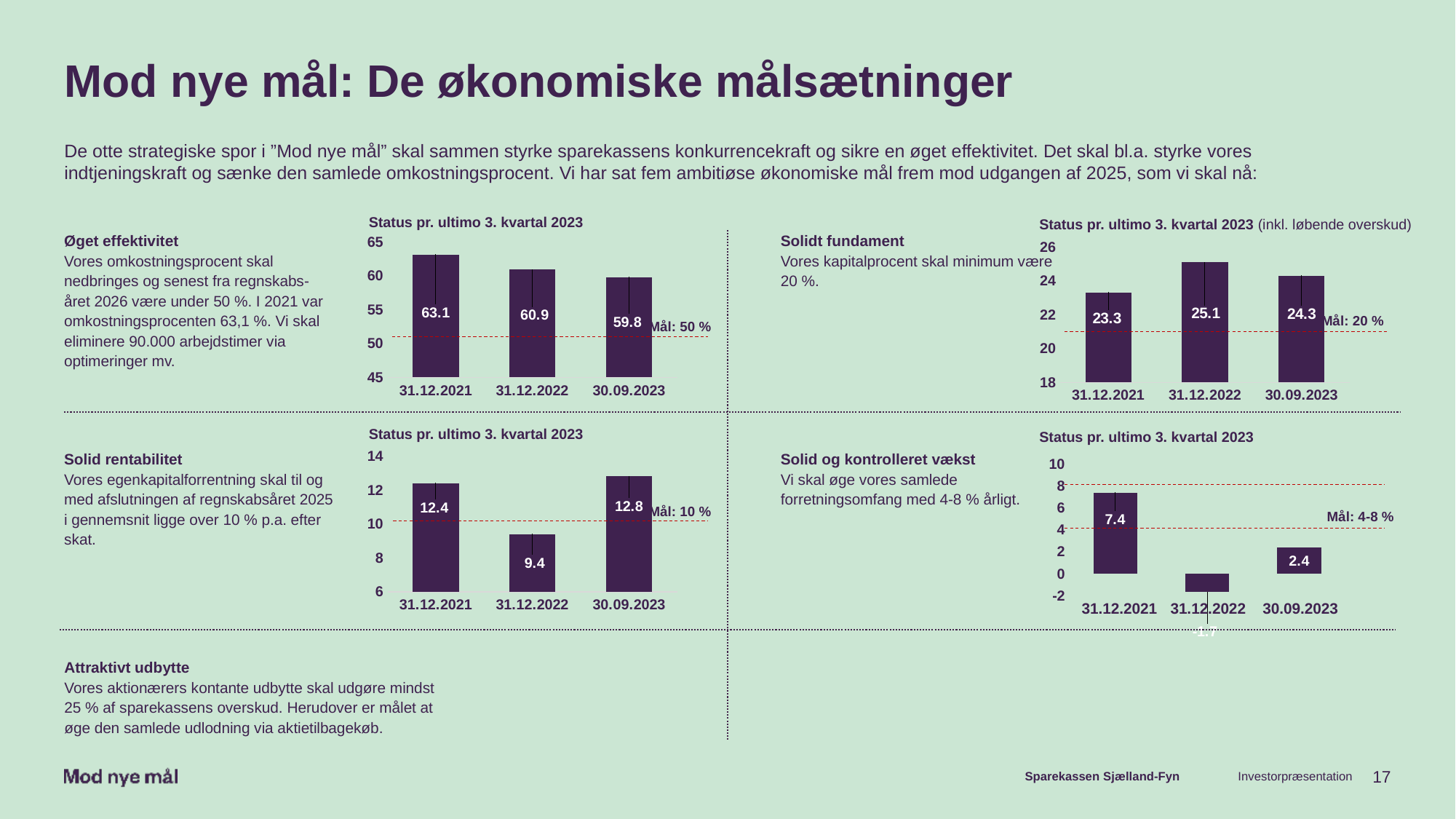
In the top-left chart (Øget effektivitet), what is the difference between the values for 31.12.2021 and 30.09.2023? 3.3 In the top-left chart (Øget effektivitet), what is the value for 31.12.2021? 63.1 What kind of chart is the top-left chart (Øget effektivitet)? Bar chart What target (Mål) is marked on the bottom-left chart (Solid rentabilitet)? Mål: 10 % In the bottom-left chart (Solid rentabilitet), which is larger, the value for 31.12.2021 or 30.09.2023? 30.09.2023 In the top-right chart (Solidt fundament), what is the value for 31.12.2022? 25.1 In the top-right chart (Solidt fundament), which date has the highest value? 31.12.2022 In the top-left chart (Øget effektivitet), which date has the lowest value? 30.09.2023 In the bottom-right chart (Solid og kontrolleret vækst), what is the value for 31.12.2022? -1.7 In the bottom-right chart (Solid og kontrolleret vækst), what is the difference between the values for 31.12.2021 and 30.09.2023? 5.0 In the bottom-left chart (Solid rentabilitet), what is the value for 31.12.2022? 9.4 How many bars are plotted in the bottom-right chart (Solid og kontrolleret vækst)? 3